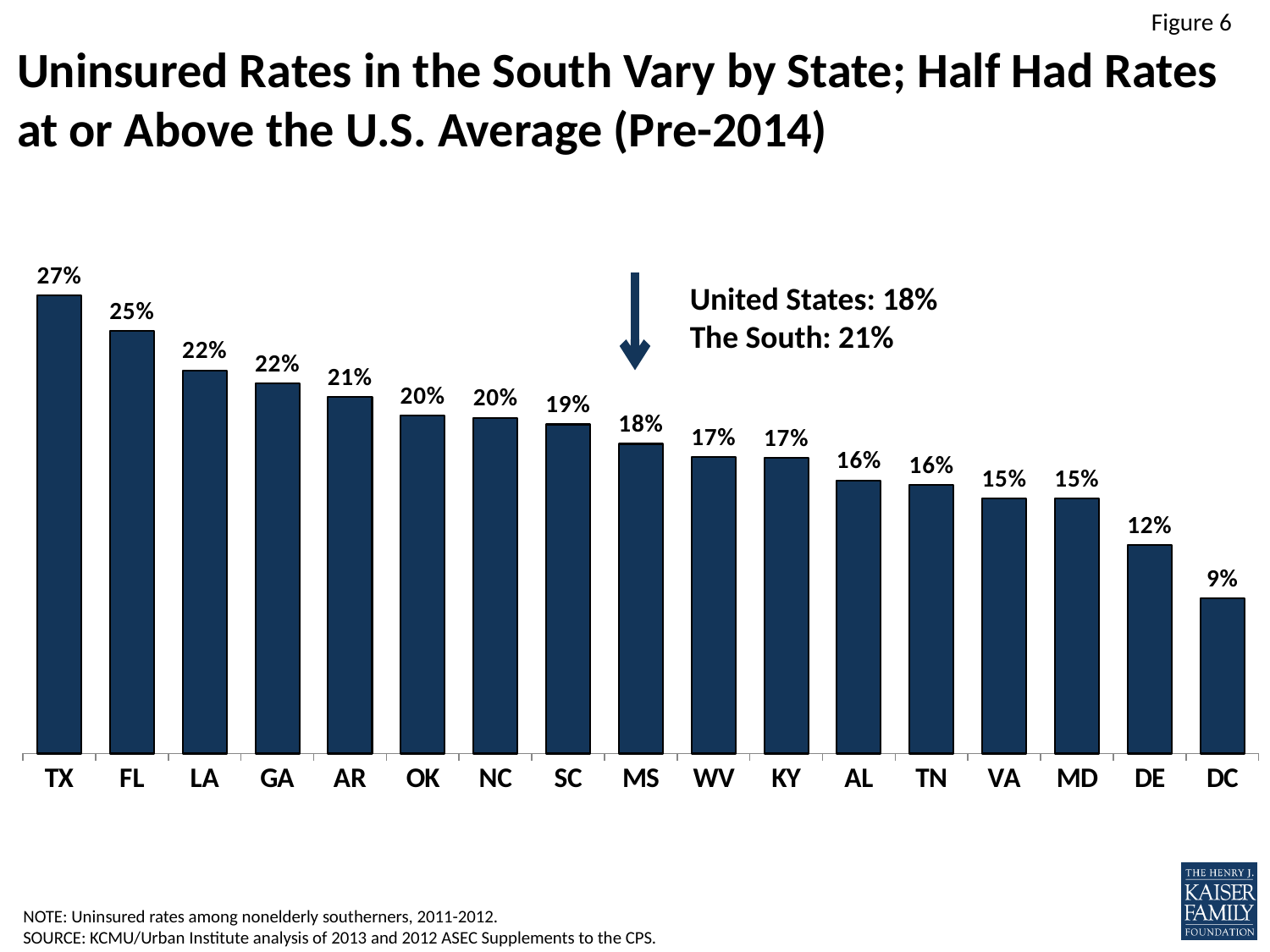
What is the difference between the uninsured rates for FL and MS? 7 percentage points What uninsured rate does the annotation give for the United States? 18% What is the uninsured rate shown for VA? 15% Which state has the highest uninsured rate on the chart? TX How many states or jurisdictions are shown as bars on the chart? 17 What kind of chart is shown on the slide? Bar chart What is the uninsured rate shown for TX? 27% Which bar has the lowest uninsured rate on the chart? DC Which has a higher uninsured rate, LA or OK? LA What is the uninsured rate shown for DE? 12% Do the uninsured rates rise or fall moving from left to right along the x axis? Fall What is the difference between the uninsured rates for TX and DC? 18 percentage points